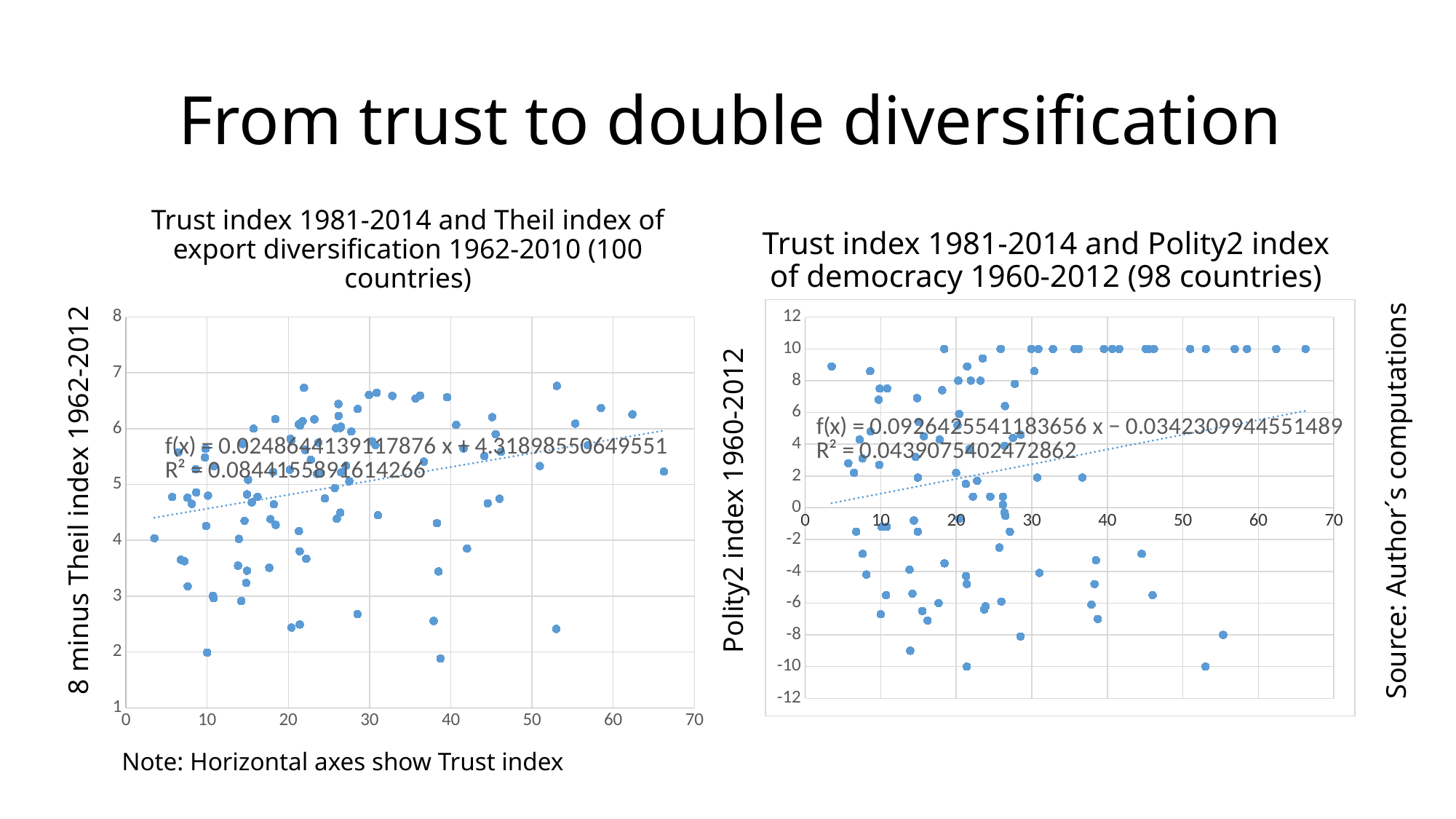
What is the vertical axis label of the right chart? Polity2 index 1960-2012 What is the vertical axis label of the left chart? 8 minus Theil index 1962-2012 In the left chart, does the fitted trendline rise or fall as the Trust index increases? Rises What R² value is printed on the right chart? 0.0439075402472862 What kind of chart is the right chart, 'Trust index 1981-2014 and Polity2 index of democracy 1960-2012 (98 countries)'? Scatter chart How many countries does the title of the right chart say are included? 98 In the right chart, does the fitted trendline rise or fall as the Trust index increases? Rises What is the intercept in the trendline equation printed on the left chart? 4.31898550649551 What kind of chart is the left chart, 'Trust index 1981-2014 and Theil index of export diversification 1962-2010 (100 countries)'? Scatter chart Which chart reports the higher R² value, the left chart or the right chart? The left chart What is the slope coefficient in the trendline equation printed on the right chart? 0.0926425541183656 What is the highest tick value shown on the vertical axis of the right chart? 12